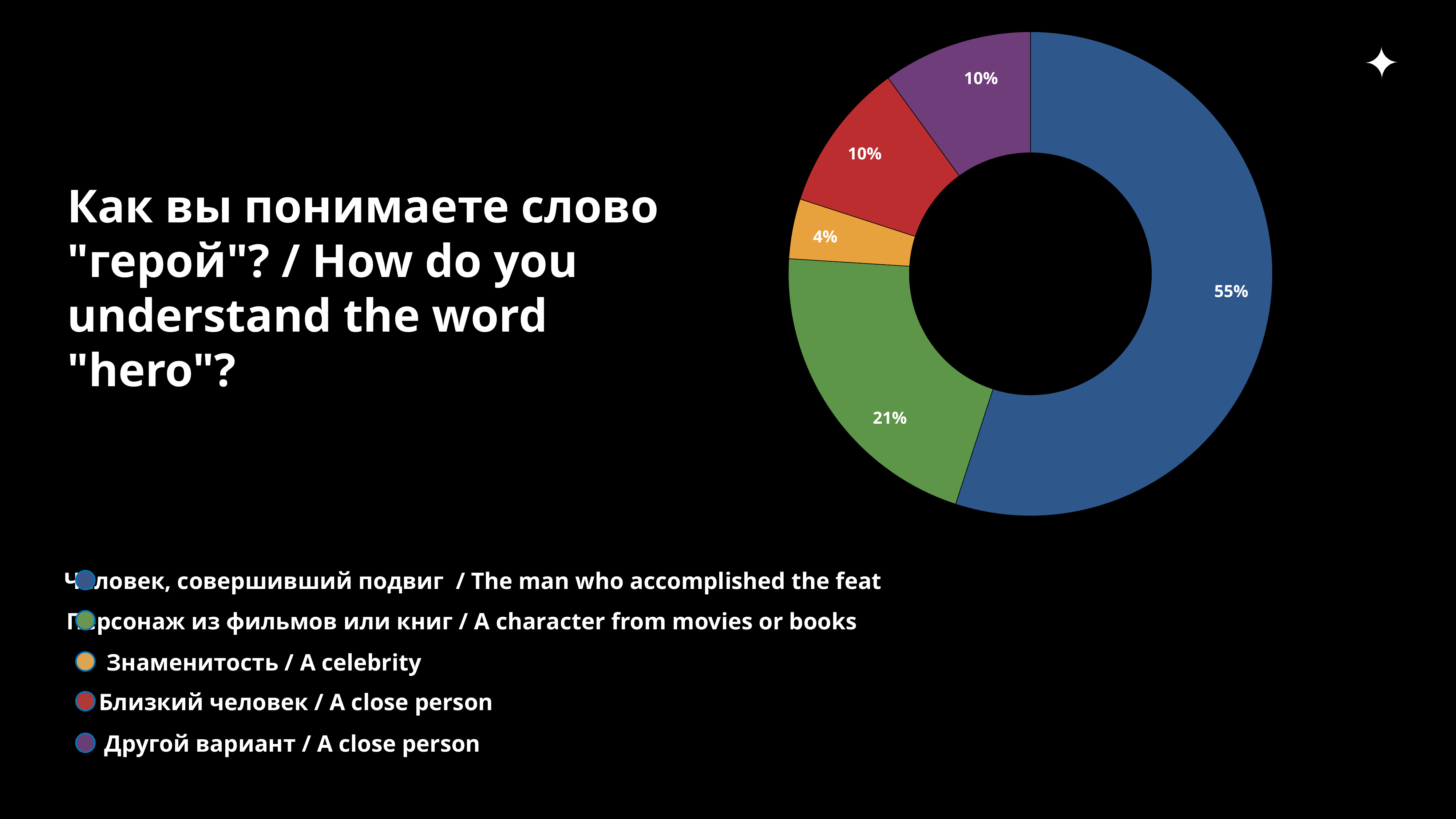
What share of respondents chose "Близкий человек / A close person" (the red slice)? 10% What share of respondents chose "A character from movies or books"? 21% Which answer option has the smallest share of the chart? A celebrity What share of respondents chose "A celebrity"? 4% What share of respondents chose "The man who accomplished the feat"? 55% How many slices does the donut chart have? 5 Which is larger: the share for "A character from movies or books" or the share for "A celebrity"? A character from movies or books What colour is the slice representing "A celebrity"? Orange Which answer option has the largest share of the chart? The man who accomplished the feat How many percentage points larger is the share for "The man who accomplished the feat" than for "A character from movies or books"? 34 percentage points What share of respondents chose "Другой вариант" (the purple slice)? 10% What kind of chart is shown on the slide? Donut (pie) chart